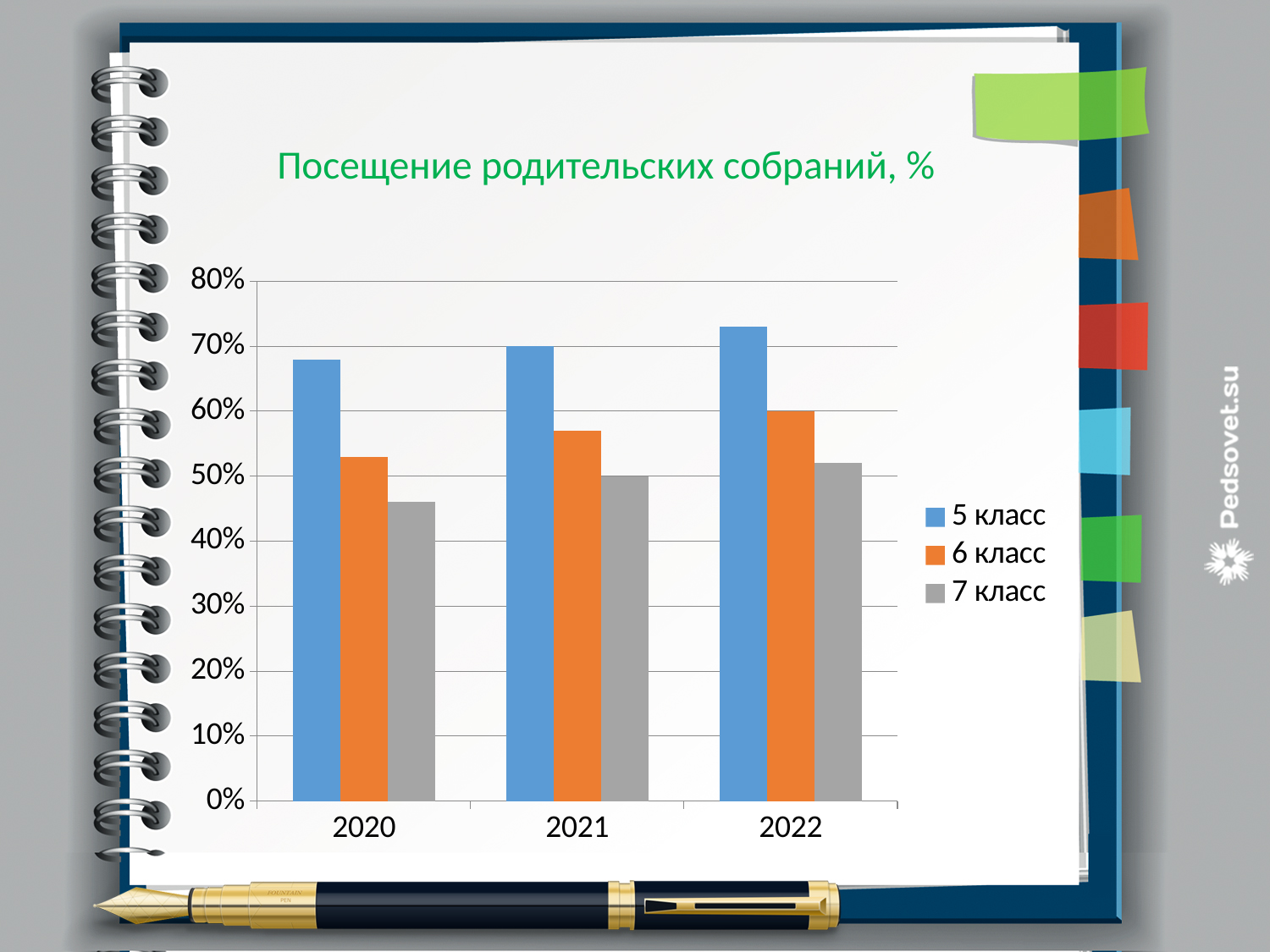
What is the title of the chart? Посещение родительских собраний, % How many series does the legend list? 3 Do the values for 5 класс rise or fall from 2020 to 2022? rise Which colour represents 7 класс in the legend? grey How many years are shown on the x axis? 3 Which series has the lowest value in 2020? 7 класс Is the value for 6 класс in 2021 greater or less than 60%? less What kind of chart is shown on the slide? bar chart Which is larger: the value for 6 класс in 2022 or the value for 7 класс in 2022? 6 класс in 2022 Is the value for 7 класс in 2020 greater or less than 50%? less Is the value for 5 класс in 2020 greater or less than 60%? greater Which series has the highest value in 2022? 5 класс